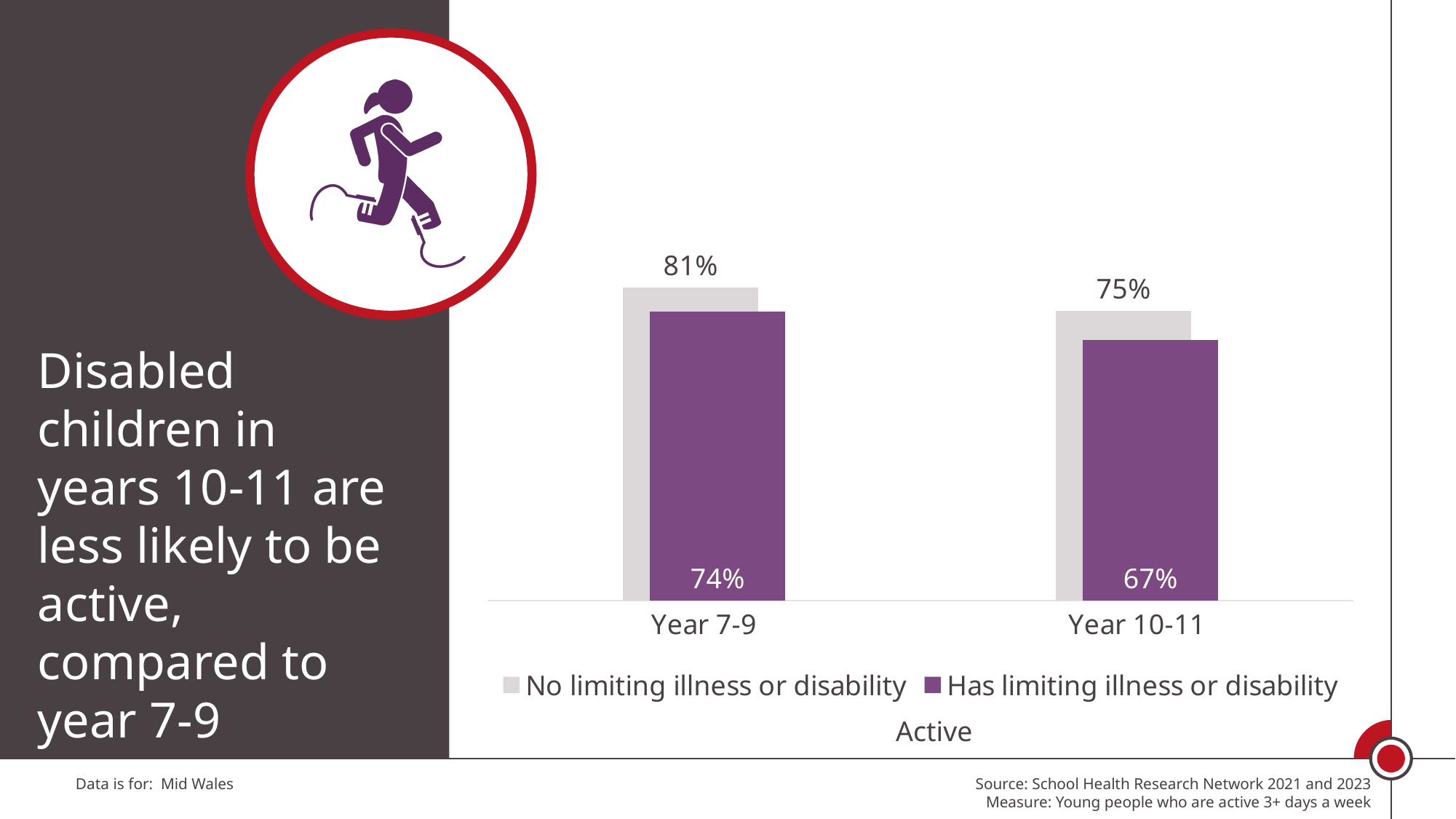
How many series does the legend list? 2 Which bar has the lowest value on the chart? Has limiting illness or disability, Year 10-11 What is the value for 'Has limiting illness or disability' in Year 10-11? 67% What is the difference between the 'No limiting illness or disability' and 'Has limiting illness or disability' values in Year 10-11? 8% Which bar has the highest value on the chart? No limiting illness or disability, Year 7-9 What is the title shown below the chart's legend? Active What is the value for 'No limiting illness or disability' in Year 10-11? 75% What is the value for 'Has limiting illness or disability' in Year 7-9? 74% What is the value for 'No limiting illness or disability' in Year 7-9? 81% What kind of chart is shown on the slide? Bar chart What is the difference between the 'Has limiting illness or disability' values for Year 7-9 and Year 10-11? 7% Which is larger: the 'Has limiting illness or disability' value in Year 7-9 or the 'No limiting illness or disability' value in Year 10-11? No limiting illness or disability in Year 10-11